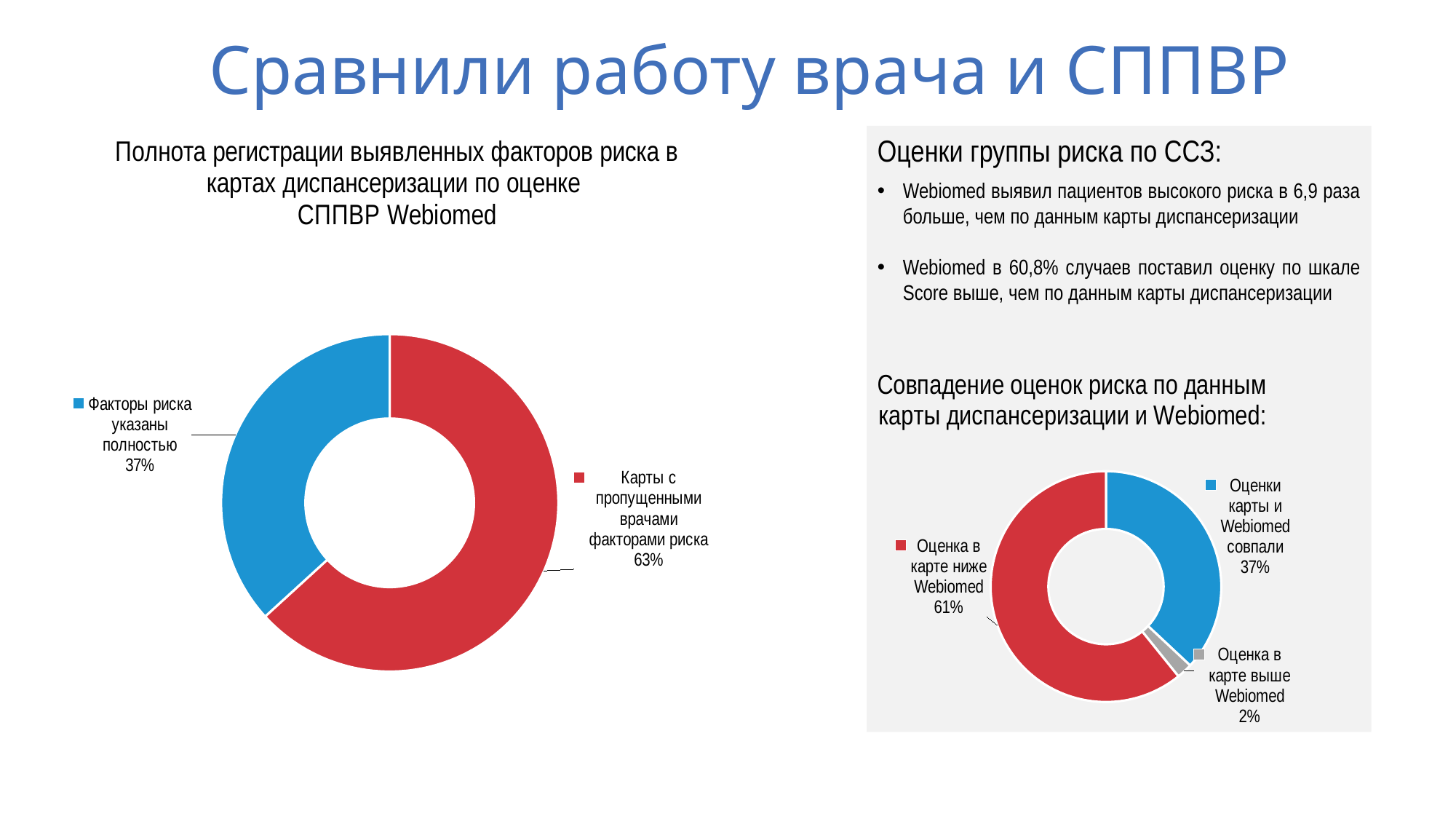
In the right chart, which is larger: 'Оценки карты и Webiomed совпали' or 'Оценка в карте ниже Webiomed'? Оценка в карте ниже Webiomed In the right chart (Совпадение оценок риска), what share of cases had the card's assessment lower than Webiomed (Оценка в карте ниже Webiomed)? 61% In the right chart, what share of cases had matching assessments (Оценки карты и Webiomed совпали)? 37% In the left chart, which slice is the largest? Карты с пропущенными врачами факторами риска In the right chart, which slice is the smallest? Оценка в карте выше Webiomed In the left chart, what is the difference in percentage points between the two slices? 26 What type of chart is the left chart? Doughnut (pie) chart In the left chart, what share is labelled 'Карты с пропущенными врачами факторами риска'? 63% How many slices does the right chart have? 3 How many slices does the left chart have? 2 In the right chart, what share of cases had the card's assessment higher than Webiomed (Оценка в карте выше Webiomed)? 2% In the left chart (Полнота регистрации выявленных факторов риска), what share of cards have risk factors fully recorded (Факторы риска указаны полностью)? 37%